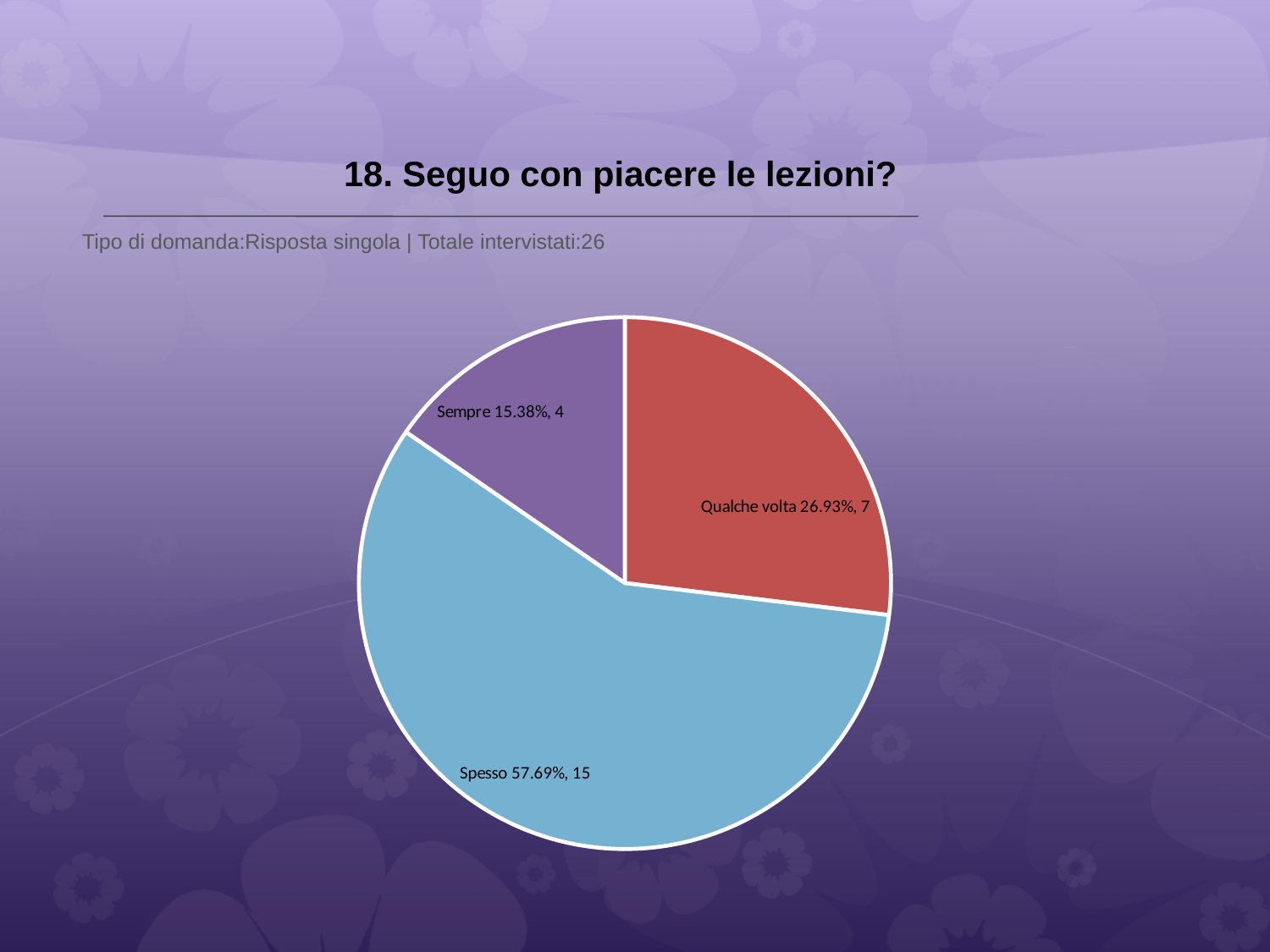
What percentage share does the 'Qualche volta' slice have? 26.93% What kind of chart is shown on the slide? pie chart How many respondents answered 'Qualche volta'? 7 How many respondents answered 'Sempre'? 4 Which response has the largest slice of the pie? Spesso What percentage share does the 'Sempre' slice have? 15.38% Which has more respondents, 'Qualche volta' or 'Sempre'? Qualche volta What percentage share does the 'Spesso' slice have? 57.69% Which response has the smallest slice of the pie? Sempre What is the difference in respondent count between 'Spesso' and 'Qualche volta'? 8 How many slices does the pie chart have? 3 How many respondents answered 'Spesso'? 15